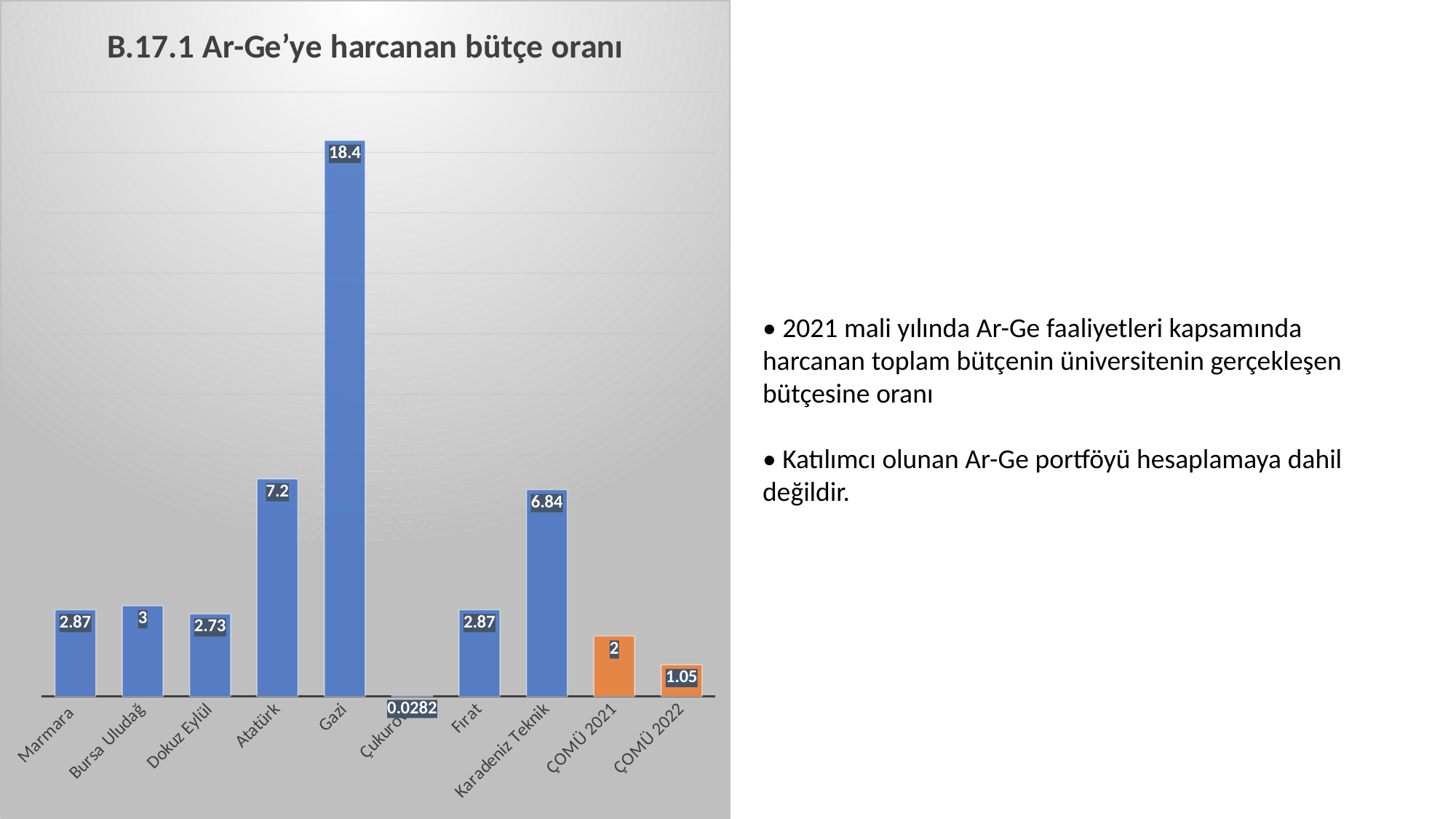
How many categories are shown on the x axis? 10 What is the title of the chart? B.17.1 Ar-Ge'ye harcanan bütçe oranı What is the value for Atatürk? 7.2 What kind of chart is shown on the slide? Bar chart What is the value for Gazi? 18.4 What is the difference between the values for Gazi and Atatürk? 11.2 What is the value for Çukurova? 0.0282 Which category has the highest value? Gazi Which is larger, the value for Atatürk or the value for Karadeniz Teknik? Atatürk What is the value for ÇOMÜ 2022? 1.05 What is the difference between the values for ÇOMÜ 2021 and ÇOMÜ 2022? 0.95 Which category has the lowest value? Çukurova